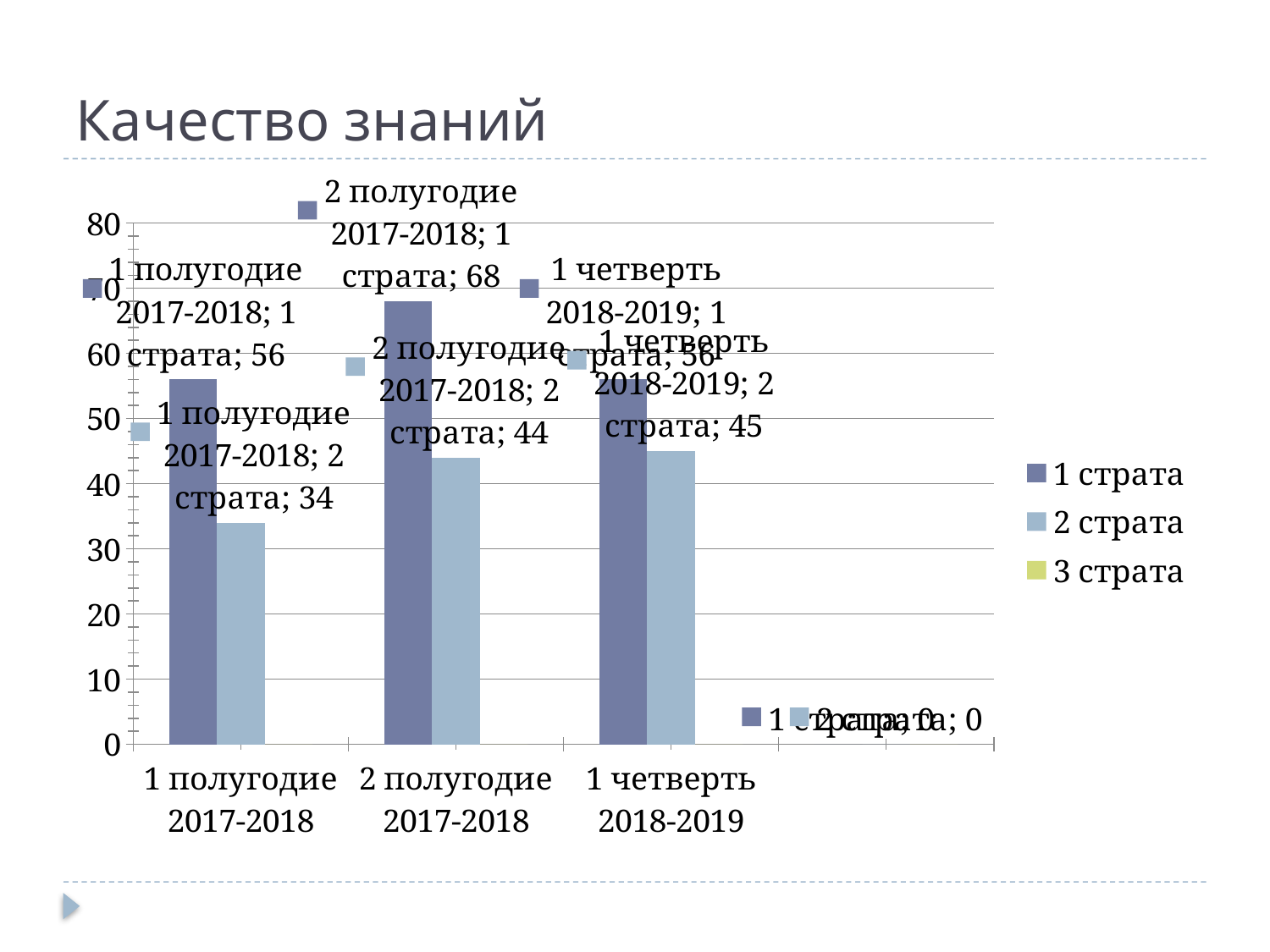
In which period is the value for 2 страта lowest? 1 полугодие 2017-2018 What is the value for 2 страта in 1 полугодие 2017-2018? 34 How many series does the legend list? 3 What is the title of the slide? Качество знаний In which period is the value for 1 страта highest? 2 полугодие 2017-2018 What is the difference between 1 страта and 2 страта in 2 полугодие 2017-2018? 24 What is the value for 1 страта in 2 полугодие 2017-2018? 68 Which is larger in 1 полугодие 2017-2018: 1 страта or 2 страта? 1 страта What is the value for 2 страта in 1 четверть 2018-2019? 45 What is the value for 2 страта in 2 полугодие 2017-2018? 44 What is the value for 1 страта in 1 полугодие 2017-2018? 56 What kind of chart is shown on the slide? Bar chart